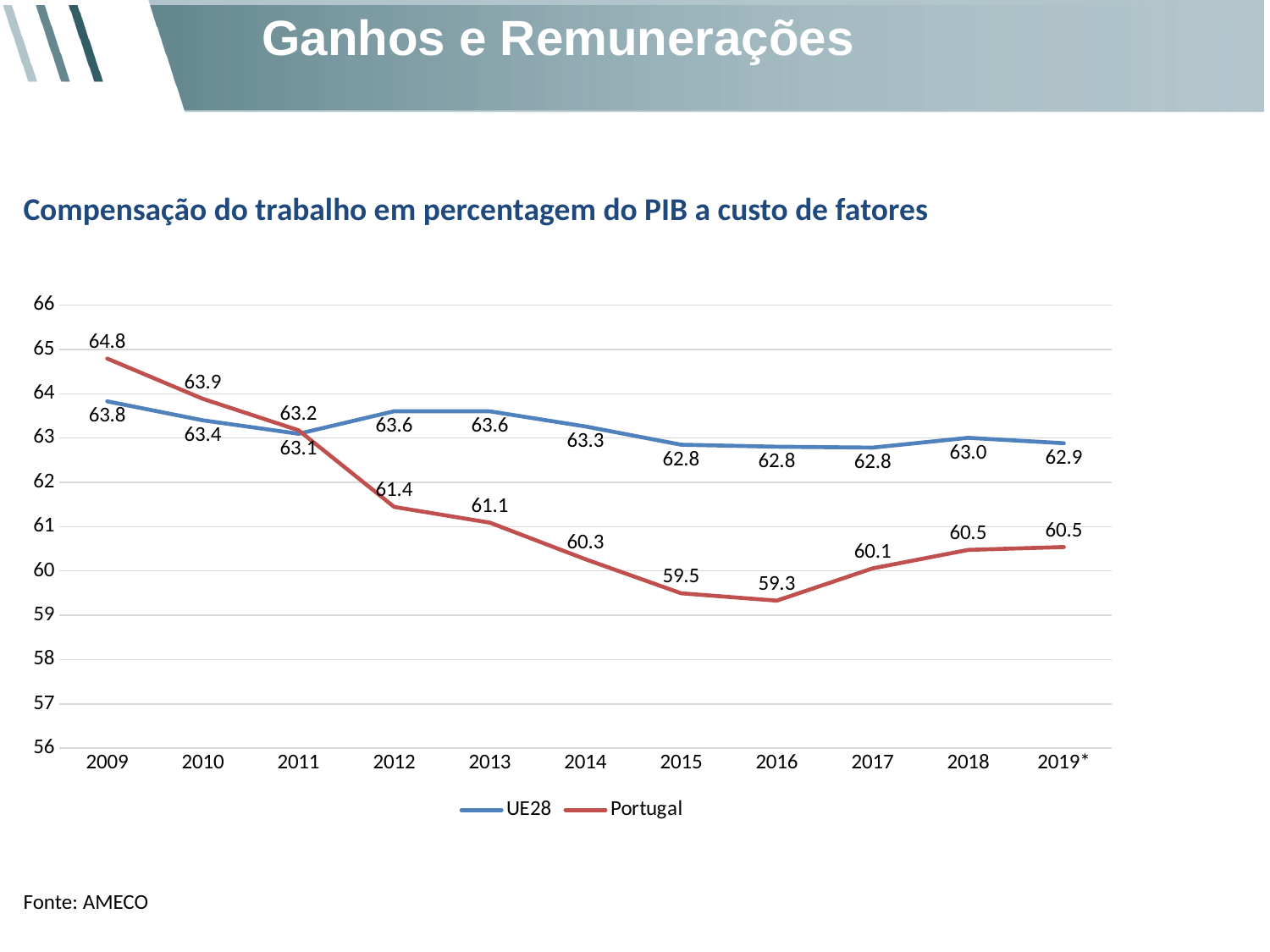
What is the difference between the UE28 and Portugal values in 2016? 3.5 Which series has the higher value in 2014, UE28 or Portugal? UE28 What type of chart is shown on the slide? Line chart What is the value for Portugal in 2019*? 60.5 What is the value for UE28 in 2016? 62.8 How many series does the legend list? 2 What is the value for Portugal in 2009? 64.8 What is the title of the chart? Compensação do trabalho em percentagem do PIB a custo de fatores Does the Portugal series rise or fall from 2009 to 2016? Fall In which year is the Portugal series at its lowest? 2016 How many years are shown on the x axis? 11 In which year is the Portugal series at its highest? 2009